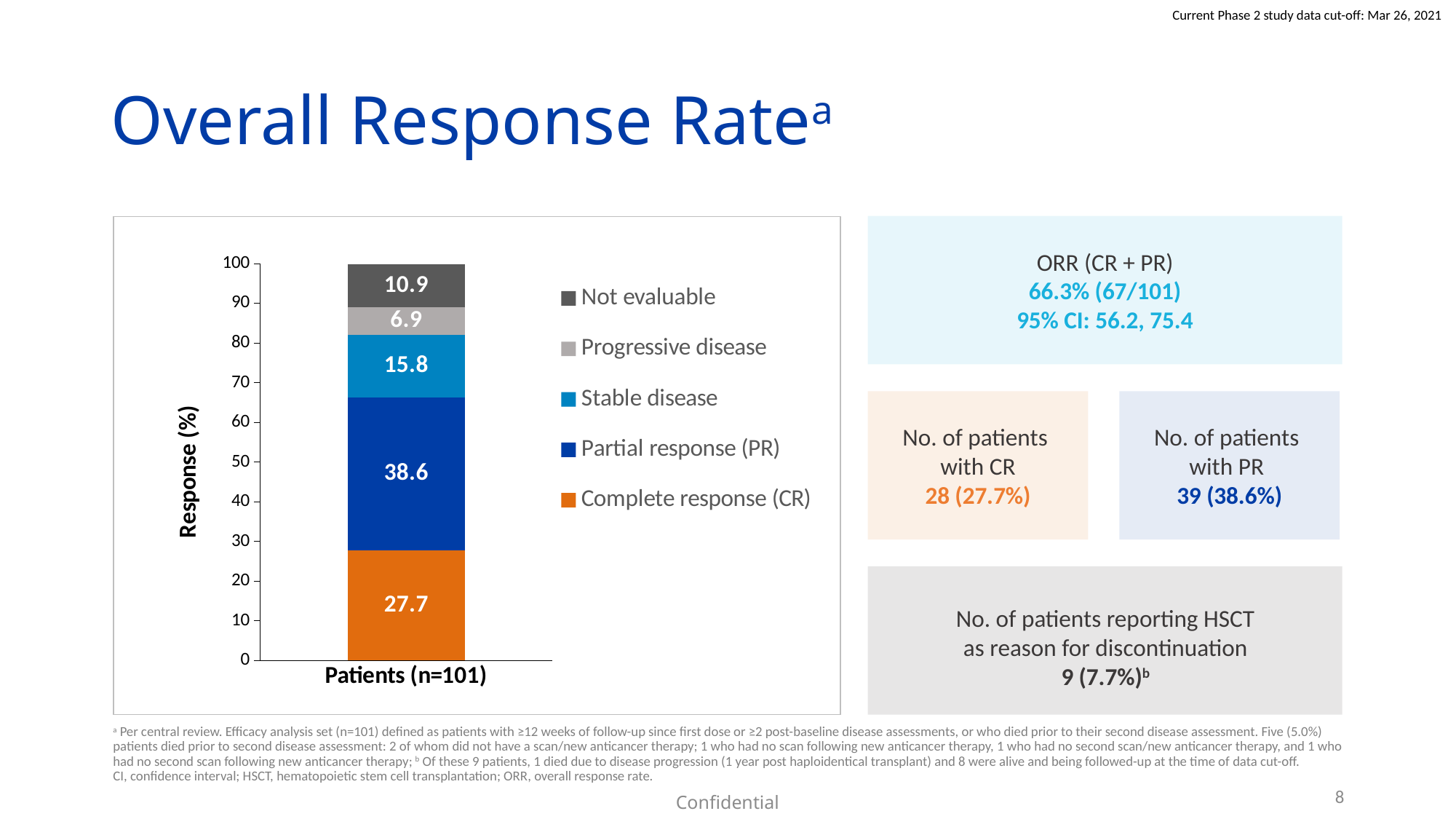
What is the value for Complete response (CR) in the stacked bar? 27.7 How many series does the legend list? 5 Which series has the smallest segment in the stacked bar? Progressive disease What is the label on the y axis of the chart? Response (%) What is the difference between the Partial response (PR) and Complete response (CR) values? 10.9 What is the value for Stable disease in the stacked bar? 15.8 Which series has the largest segment in the stacked bar? Partial response (PR) What is the value for Progressive disease in the stacked bar? 6.9 Which is larger, the Stable disease value or the Not evaluable value? Stable disease What kind of chart is shown on the slide? Stacked bar chart What is the value for Partial response (PR) in the stacked bar? 38.6 What is the value for Not evaluable in the stacked bar? 10.9